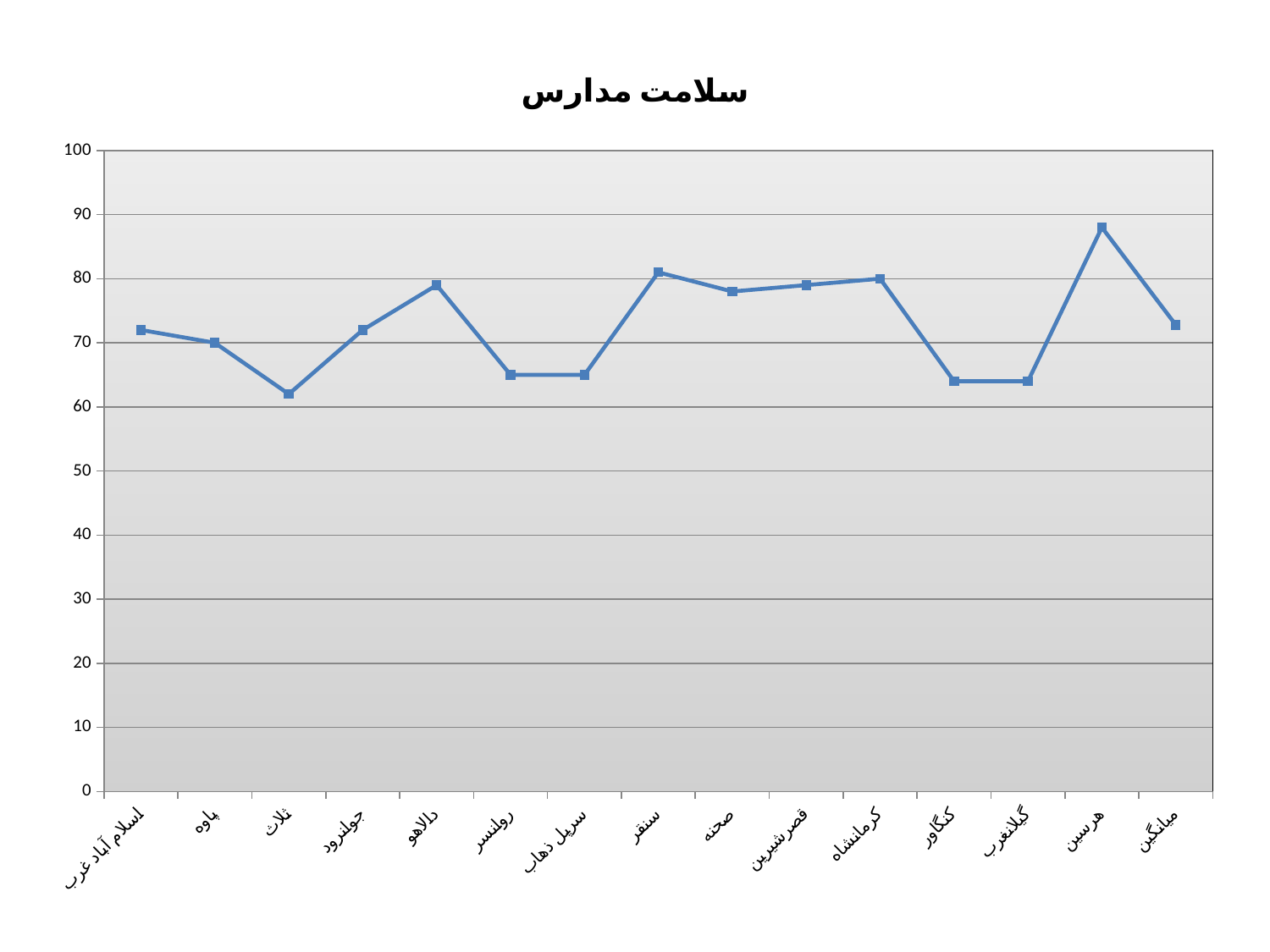
Which category has the highest value? هرسین Is the value for ثلاث greater or less than 70? less Is the value for سنقر greater or less than 70? greater How many categories are plotted along the x axis? 15 Which has the larger value, هرسین or ثلاث? هرسین Is the value for کنگاور greater or less than 70? less Do the values rise or fall from ثلاث to دالاهو? rise Which has the larger value, دالاهو or روانسر? دالاهو What is the title of the chart? سلامت مدارس What kind of chart is shown on the slide? line chart